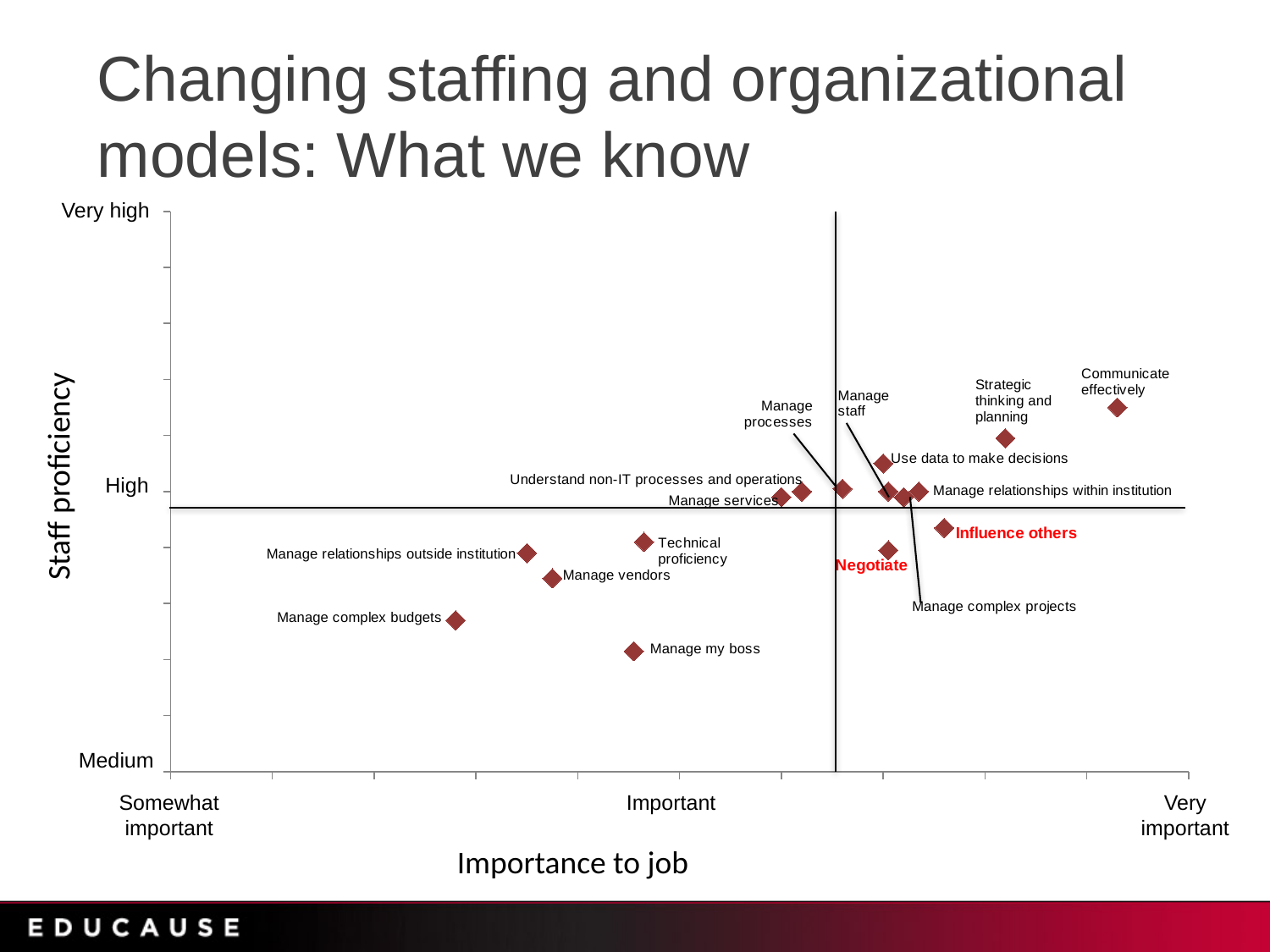
What is the title of the x axis of the chart? Importance to job What kind of chart is shown on the slide? Scatter plot Which skill is rated least important to the job (furthest left on the chart)? Manage complex budgets Which skill is rated most important to the job (furthest right on the chart)? Communicate effectively Is the importance to job for Manage complex budgets greater or less than "Important" on the x axis? less Is the staff proficiency for Communicate effectively above or below the "High" level on the y axis? above Which skill has the highest staff proficiency on the chart? Communicate effectively Which skill has higher staff proficiency, Strategic thinking and planning or Manage vendors? Strategic thinking and planning Which skill has the lowest staff proficiency on the chart? Manage my boss How many skills are plotted as points on the chart? 16 Which two skill labels on the chart are printed in red? Negotiate and Influence others Is the staff proficiency for Manage my boss above or below the "High" level on the y axis? below